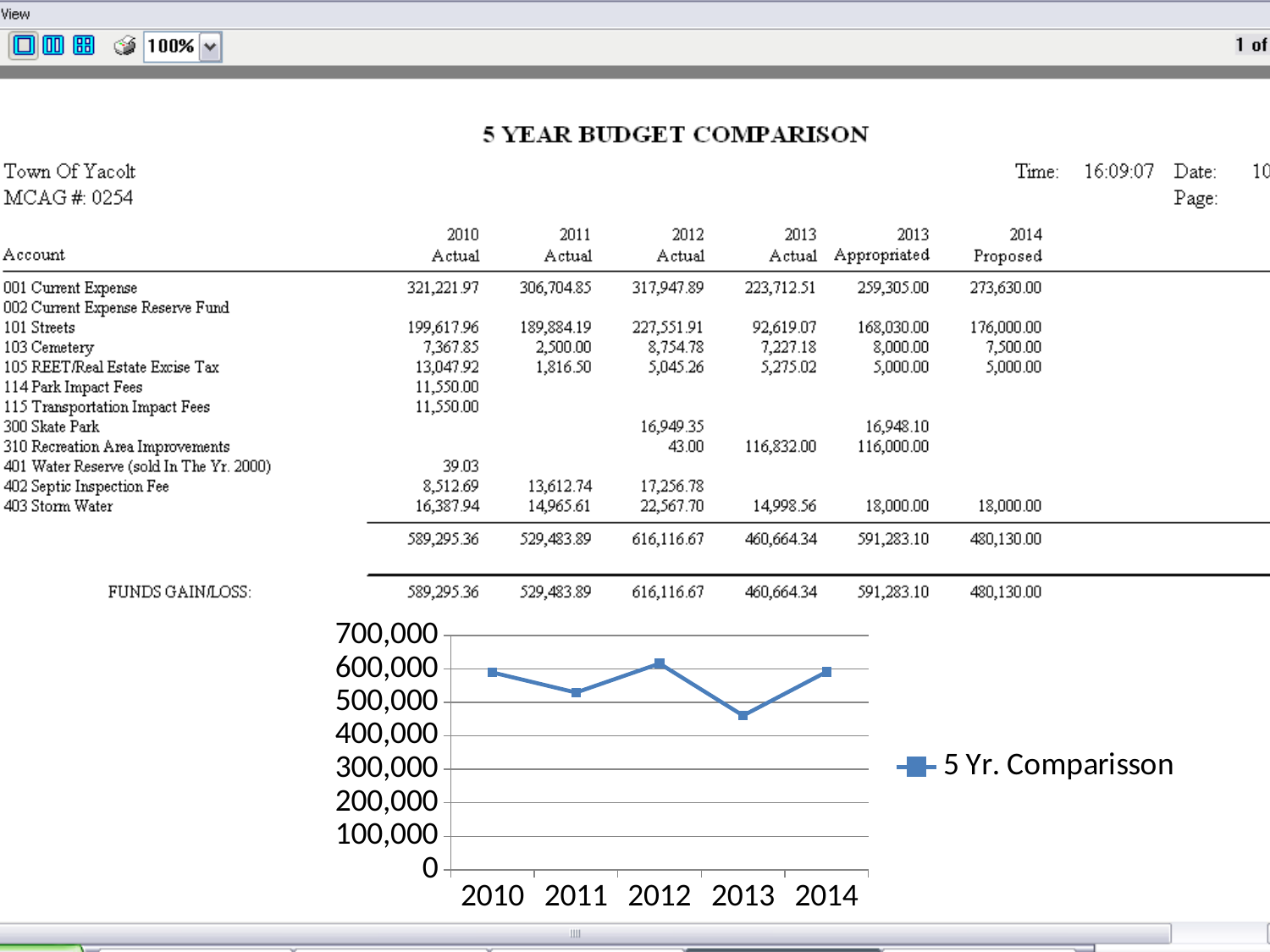
How many years are plotted on the x axis of the chart? 5 Is the value for 2011 greater or less than 500,000? greater Does the line rise or fall from 2013 to 2014? rise Which year has the lowest value in the chart? 2013 Is the value for 2012 greater or less than 600,000? greater Does the line rise or fall from 2012 to 2013? fall Which year has the highest value in the chart? 2012 How many series does the chart legend list? 1 Which is larger in the chart, the value for 2011 or the value for 2013? 2011 Is the value for 2013 greater or less than 500,000? less What kind of chart is shown on the slide? line chart What is the name of the series shown in the chart legend? 5 Yr. Comparisson